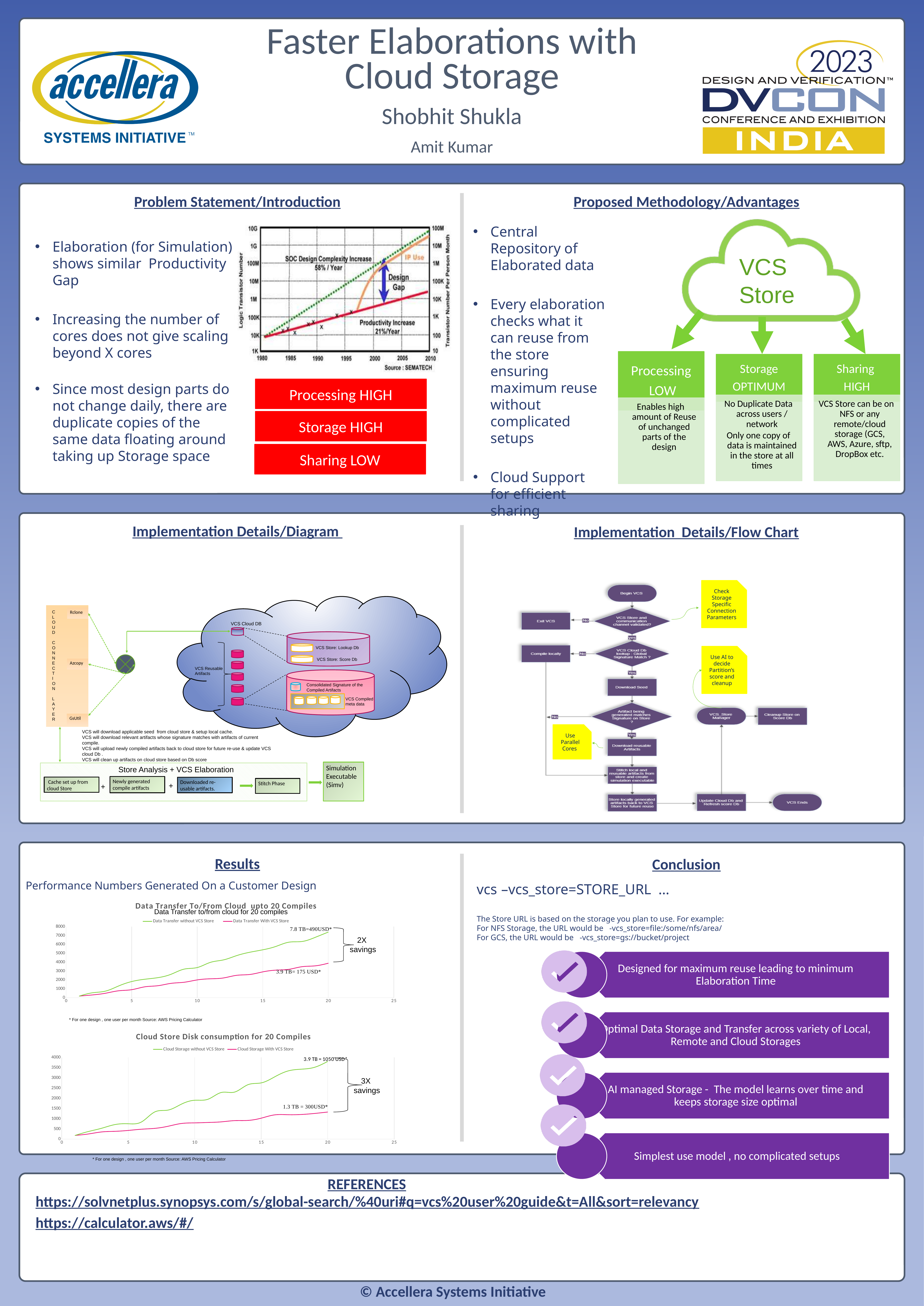
In the 'Data Transfer To/From Cloud upto 20 Compiles' chart, do the values rise or fall as the number of compiles increases? rise What are the two legend entries in the 'Data Transfer To/From Cloud upto 20 Compiles' chart? Data Transfer without VCS Store; Data Transfer With VCS Store How many series does the legend of the 'Cloud Store Disk consumption for 20 Compiles' chart list? 2 In the 'Data Transfer To/From Cloud upto 20 Compiles' chart, is the value for Data Transfer without VCS Store at 20 compiles greater or less than 6000? greater In the 'Cloud Store Disk consumption for 20 Compiles' chart, which series is lower across the compiles: Cloud Storage without VCS Store or Cloud Storage With VCS Store? Cloud Storage With VCS Store In the 'Cloud Store Disk consumption for 20 Compiles' chart, is the value for Cloud Storage With VCS Store at 20 compiles greater or less than 1500? less In the 'Data Transfer To/From Cloud upto 20 Compiles' chart, which series is higher at 20 compiles: Data Transfer without VCS Store or Data Transfer With VCS Store? Data Transfer without VCS Store What kind of chart is the 'Data Transfer To/From Cloud upto 20 Compiles' chart? line chart In the 'Cloud Store Disk consumption for 20 Compiles' chart, is the value for Cloud Storage without VCS Store at 20 compiles greater or less than 3000? greater According to the annotation on the 'Data Transfer To/From Cloud upto 20 Compiles' chart, what is the data transfer and cost without VCS Store at 20 compiles? 7.8 TB=490USD* What savings factor is annotated on the 'Cloud Store Disk consumption for 20 Compiles' chart? 3X savings